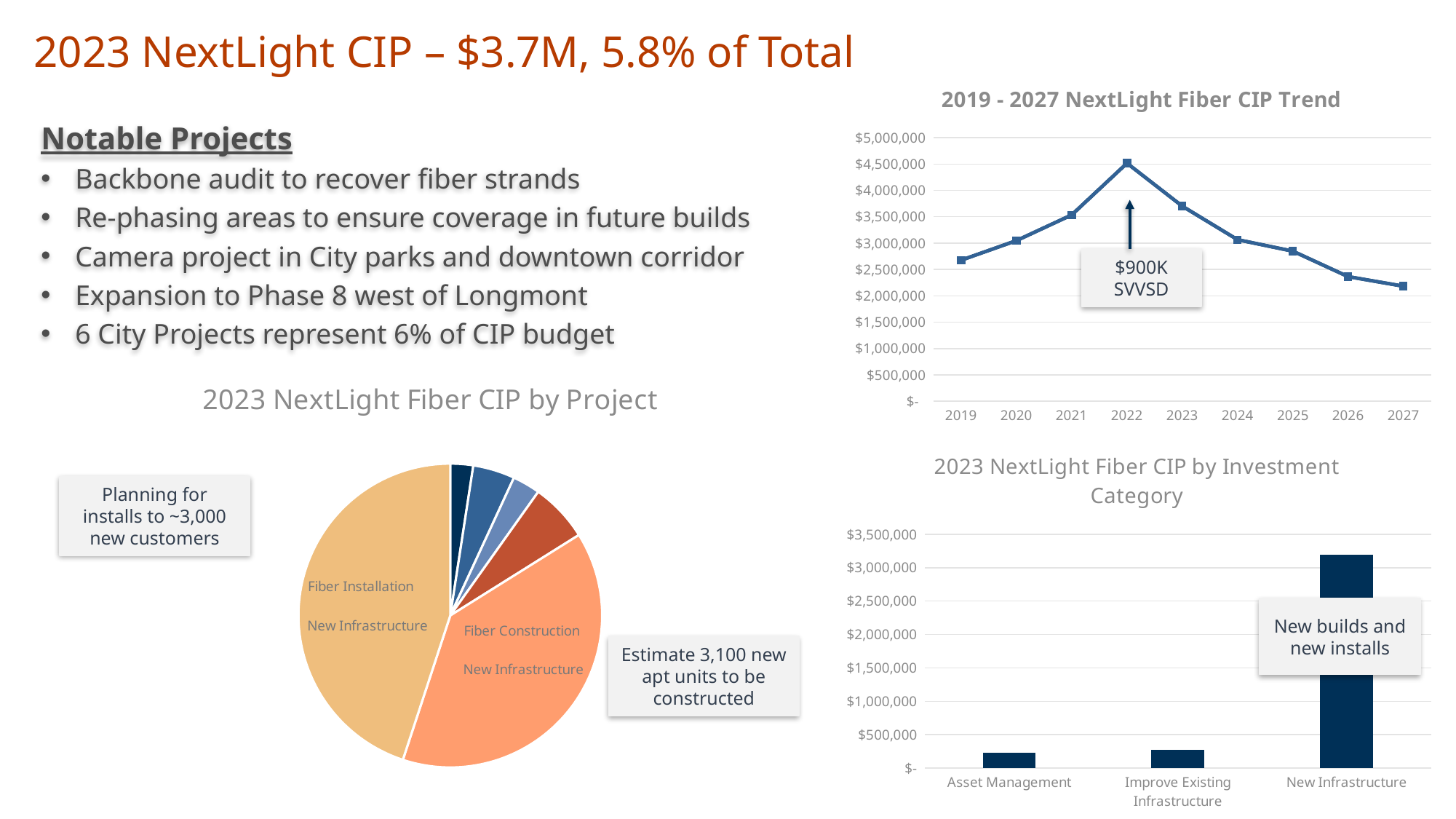
In the '2023 NextLight Fiber CIP by Project' pie chart, which labeled slice is the largest? Fiber Installation New Infrastructure In the '2019 - 2027 NextLight Fiber CIP Trend' chart, do the values rise or fall from 2022 to 2027? fall What kind of chart is the '2019 - 2027 NextLight Fiber CIP Trend' chart? line chart In the '2019 - 2027 NextLight Fiber CIP Trend' chart, is the value for 2027 greater or less than $2,500,000? less In the '2023 NextLight Fiber CIP by Investment Category' chart, is the value for Asset Management greater or less than $500,000? less In the '2023 NextLight Fiber CIP by Investment Category' chart, which category has the highest value? New Infrastructure In the '2023 NextLight Fiber CIP by Investment Category' chart, is the value for New Infrastructure greater or less than $3,000,000? greater In the '2019 - 2027 NextLight Fiber CIP Trend' chart, which year has the highest value? 2022 How many years are plotted in the '2019 - 2027 NextLight Fiber CIP Trend' chart? 9 What kind of chart is the '2023 NextLight Fiber CIP by Investment Category' chart? bar chart In the '2019 - 2027 NextLight Fiber CIP Trend' chart, which year has the lowest value? 2027